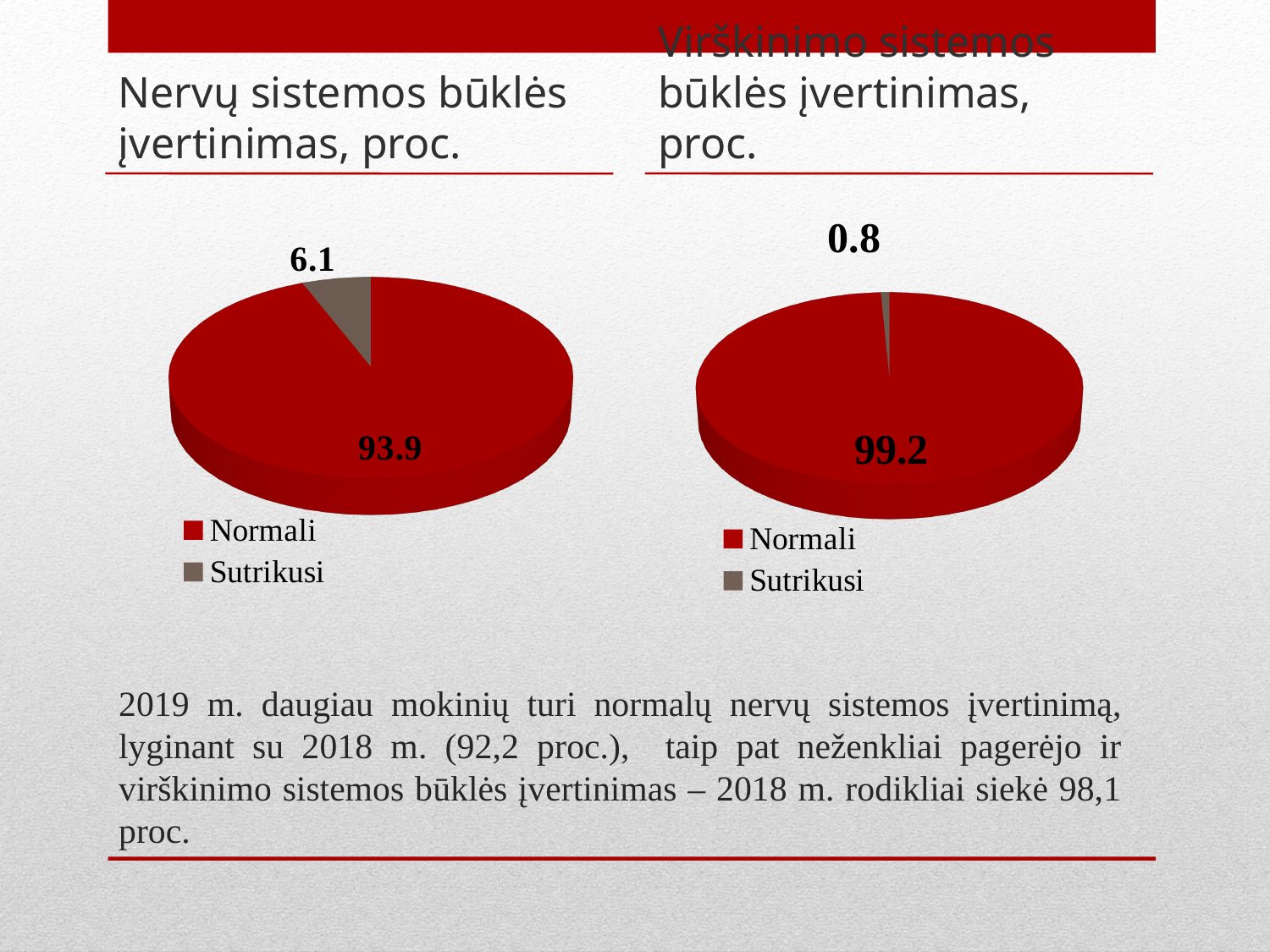
In the left chart (Nervų sistemos būklės įvertinimas, proc.), which category has the largest slice? Normali In the left chart (Nervų sistemos būklės įvertinimas, proc.), what is the value for Sutrikusi? 6.1 How many categories does the legend of the right chart (Virškinimo sistemos būklės įvertinimas, proc.) list? 2 In the right chart (Virškinimo sistemos būklės įvertinimas, proc.), what is the value for Sutrikusi? 0.8 In the right chart (Virškinimo sistemos būklės įvertinimas, proc.), what is the total of the two slice values? 100 In the left chart (Nervų sistemos būklės įvertinimas, proc.), what colour is the Sutrikusi slice? Grey What type of chart is the left chart (Nervų sistemos būklės įvertinimas, proc.)? Pie chart In the left chart (Nervų sistemos būklės įvertinimas, proc.), what is the value for Normali? 93.9 In the left chart (Nervų sistemos būklės įvertinimas, proc.), what is the difference between the Normali and Sutrikusi values? 87.8 In the right chart (Virškinimo sistemos būklės įvertinimas, proc.), what is the value for Normali? 99.2 In the right chart (Virškinimo sistemos būklės įvertinimas, proc.), which category has the smallest slice? Sutrikusi Which chart has the larger Sutrikusi value, the left chart (Nervų sistemos) or the right chart (Virškinimo sistemos)? The left chart (Nervų sistemos)